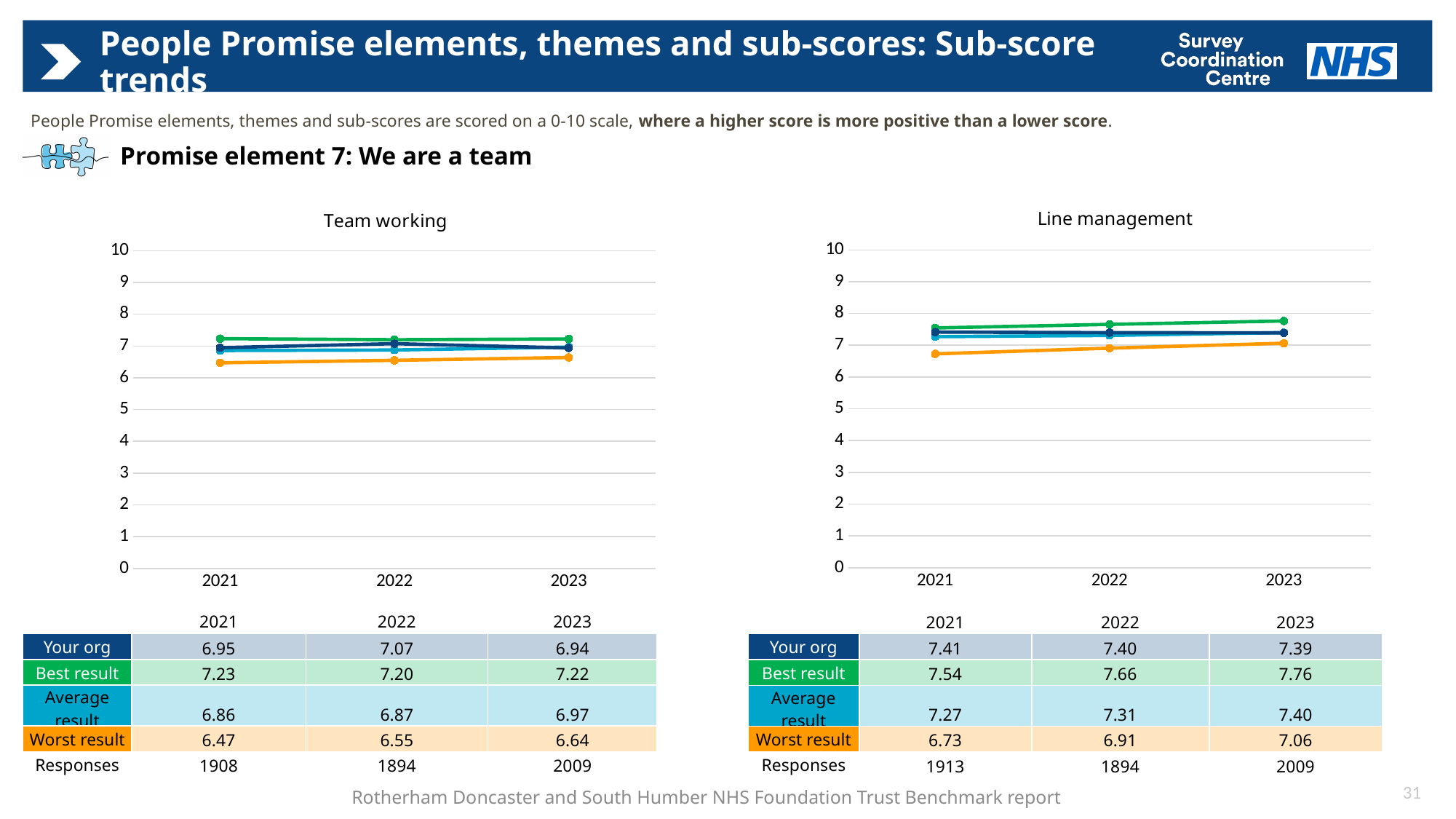
In the Team working chart, which year has the highest Your org value? 2022 In the Line management chart, does the Best result series rise or fall from 2021 to 2023? rise In the Line management chart, is the Worst result value for 2021 greater or less than 7? less In the Line management chart, which year has the lowest Worst result value? 2021 How many years are plotted on the x axis of the Team working chart? 3 In the Line management chart, what is the Best result value for 2023? 7.76 In the Team working chart, what is the Worst result value for 2021? 6.47 In the Team working chart, which is larger in 2023: the Your org value or the Average result value? Average result In the Team working chart, what is the Your org value for 2022? 7.07 In the Line management chart, what is the difference between the Best result and Your org values in 2023? 0.37 What kind of chart is the Line management chart? line chart In the Line management chart, what is the Average result value for 2022? 7.31